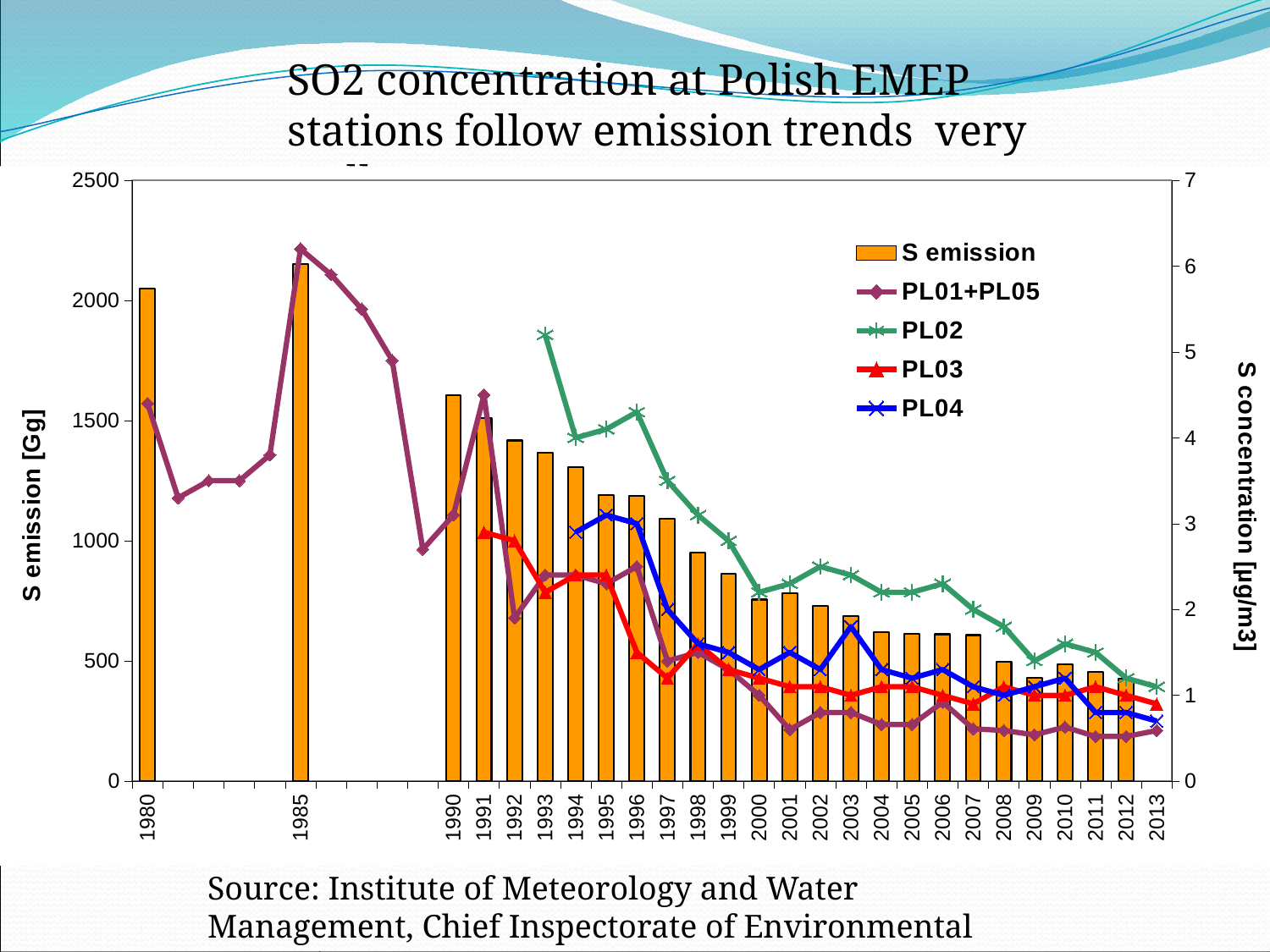
In which year does the PL01+PL05 line reach its highest value? 1985 In 1994, which series has the higher concentration, PL02 or PL03? PL02 What is the label of the right-hand vertical axis? S concentration [µg/m3] How many series does the legend list? 5 Is the S emission value for 1990 greater or less than 1500? greater In which year does the PL02 line reach its highest value? 1993 Does the S emission generally rise or fall from 1990 to 2012? Fall Is the S emission value for 2004 greater or less than 500? greater Is the PL02 concentration value for 1996 greater or less than 4? greater In which year is the S emission bar the highest? 1985 What kind of chart is shown on the slide? A combined bar and line chart